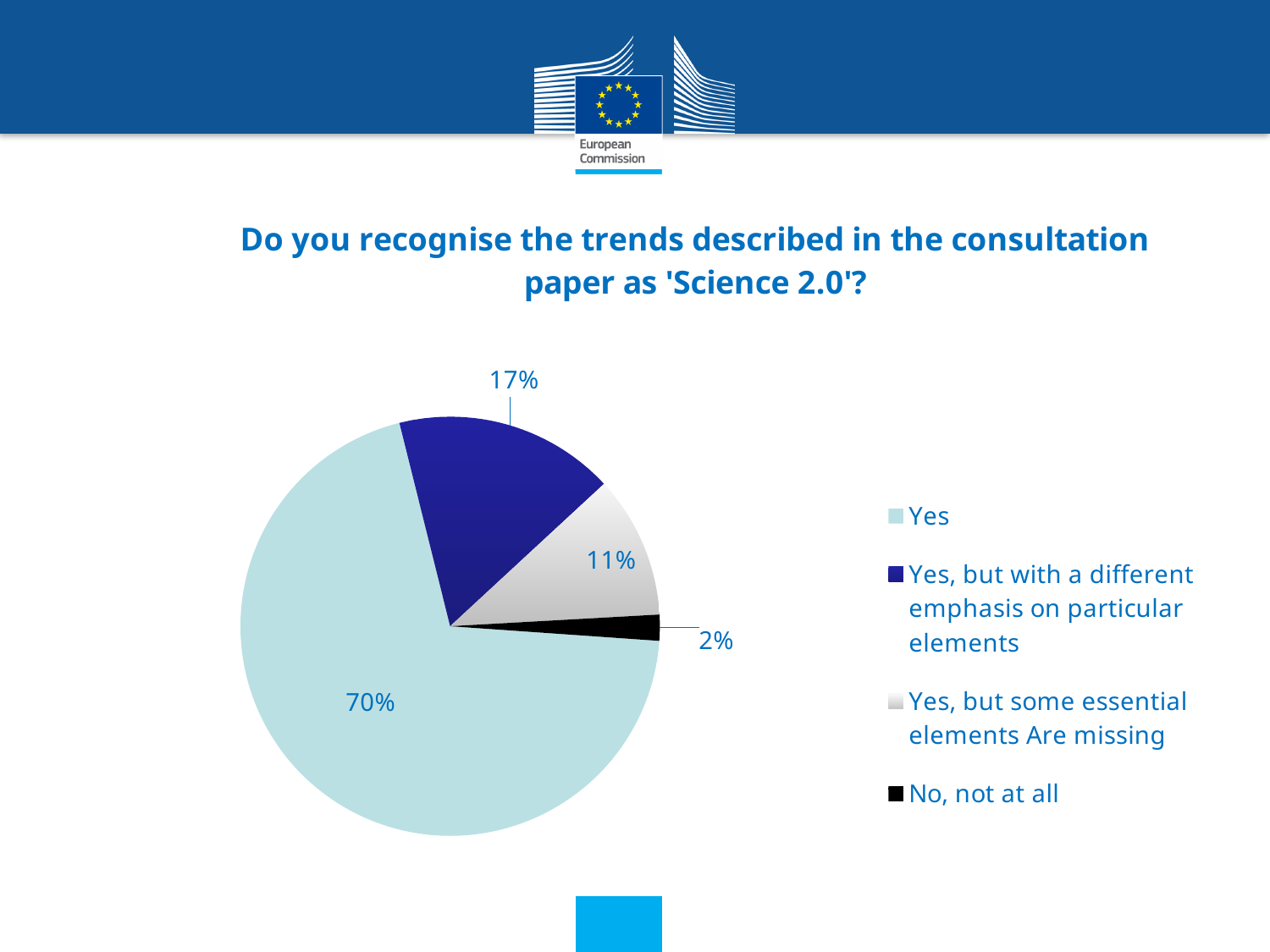
What percentage of respondents answered 'No, not at all'? 2% Which response has the smallest share of the pie? No, not at all What kind of chart is shown on the slide? pie chart What is the title of the chart? Do you recognise the trends described in the consultation paper as 'Science 2.0'? What percentage of respondents answered 'Yes'? 70% How many entries does the legend list? 4 How many slices does the pie chart have? 4 What percentage of respondents answered 'Yes, but some essential elements Are missing'? 11% What is the difference in percentage points between the 'Yes' slice and the 'Yes, but with a different emphasis on particular elements' slice? 53 What percentage of respondents answered 'Yes, but with a different emphasis on particular elements'? 17% Which is larger: the share for 'Yes, but some essential elements Are missing' or the share for 'No, not at all'? Yes, but some essential elements Are missing Which response has the largest share of the pie? Yes